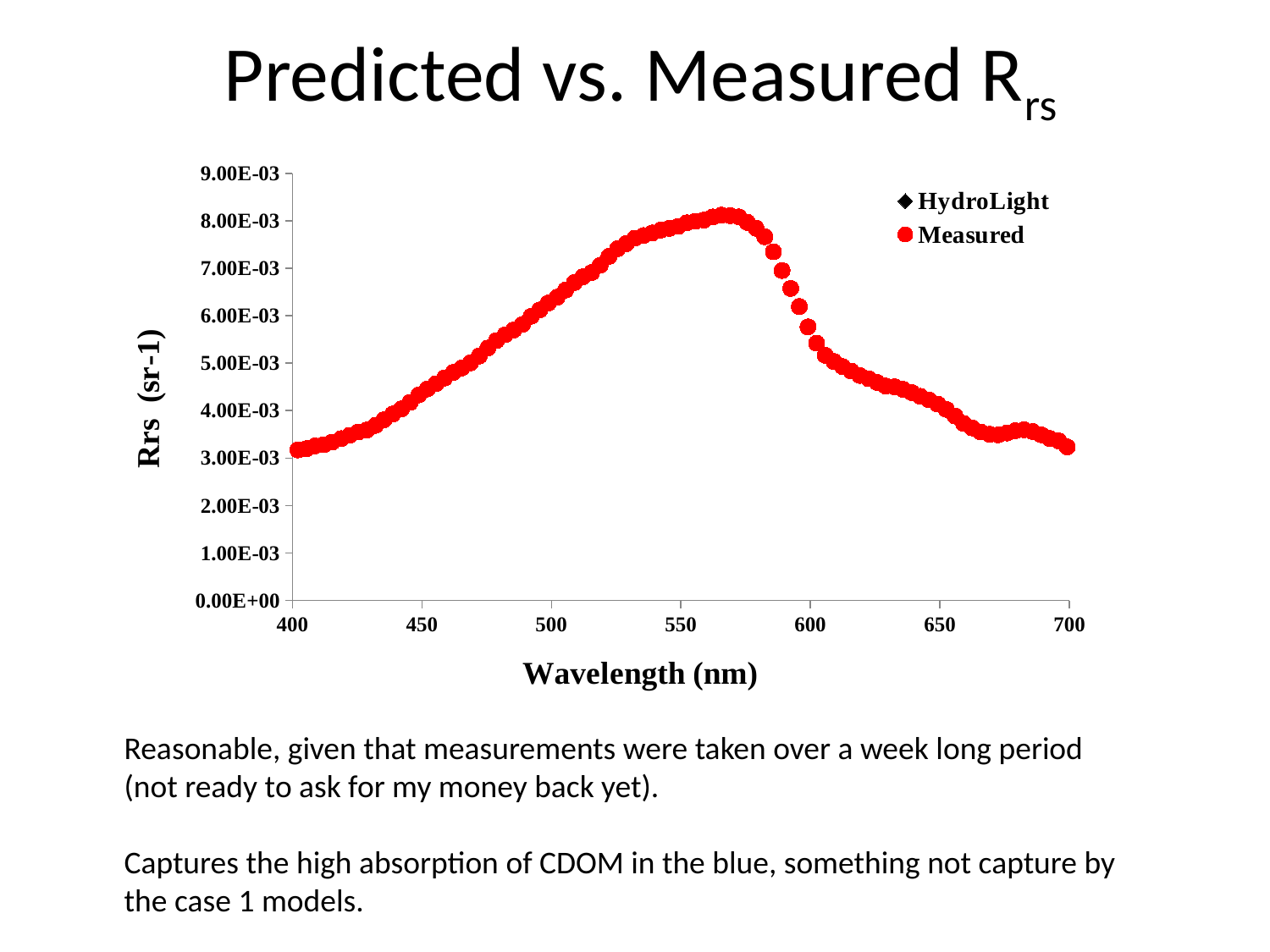
Do the Measured values rise or fall between 600 nm and 650 nm? fall Is the Measured value at 500 nm greater or less than 5.00E-03? greater What is the label of the x axis? Wavelength (nm) Is the Measured value at 550 nm greater or less than 7.00E-03? greater What are the two series named in the legend? HydroLight and Measured How many series does the legend list? 2 Is the Measured value at 650 nm greater or less than 5.00E-03? less Do the Measured values rise or fall between 400 nm and 550 nm? rise Which wavelength has the larger Measured value, 550 nm or 700 nm? 550 nm What kind of chart is shown on the slide? scatter chart